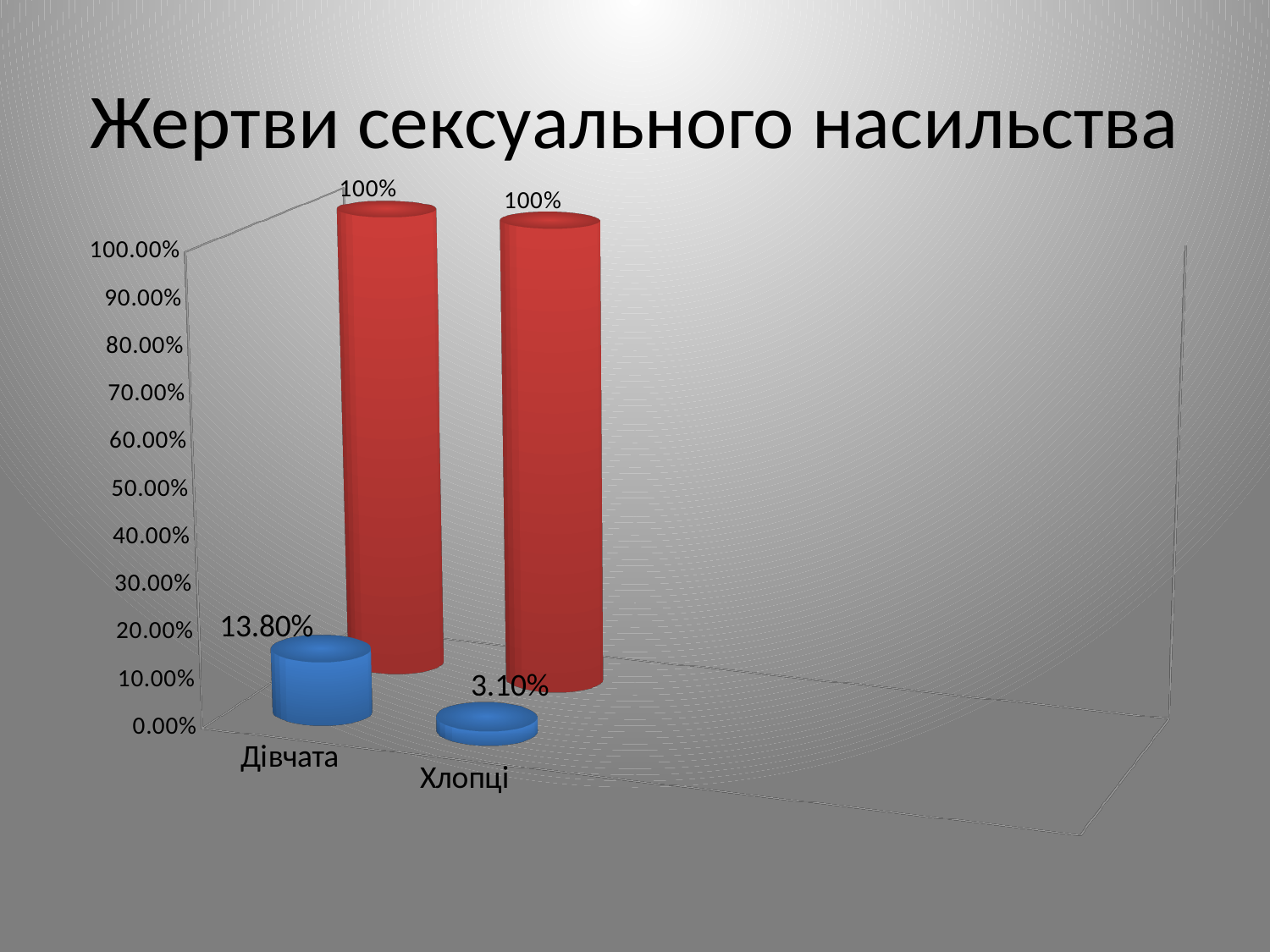
What is the value of the blue bar for Хлопці? 3.10% What kind of chart is shown on the slide? bar chart What is the difference between the blue bar values for Дівчата and Хлопці? 10.70% What is the value of the blue bar for Дівчата? 13.80% What is the title of the chart? Жертви сексуального насильства What is the value of the red bar for Дівчата? 100% How many categories are shown on the x axis? 2 Is the blue bar for Дівчата larger or smaller than the blue bar for Хлопці? larger Which category has the lowest blue bar? Хлопці Is the blue bar value for Дівчата greater or less than 20.00%? less Which category has the higher blue bar? Дівчата What is the value of the red bar for Хлопці? 100%